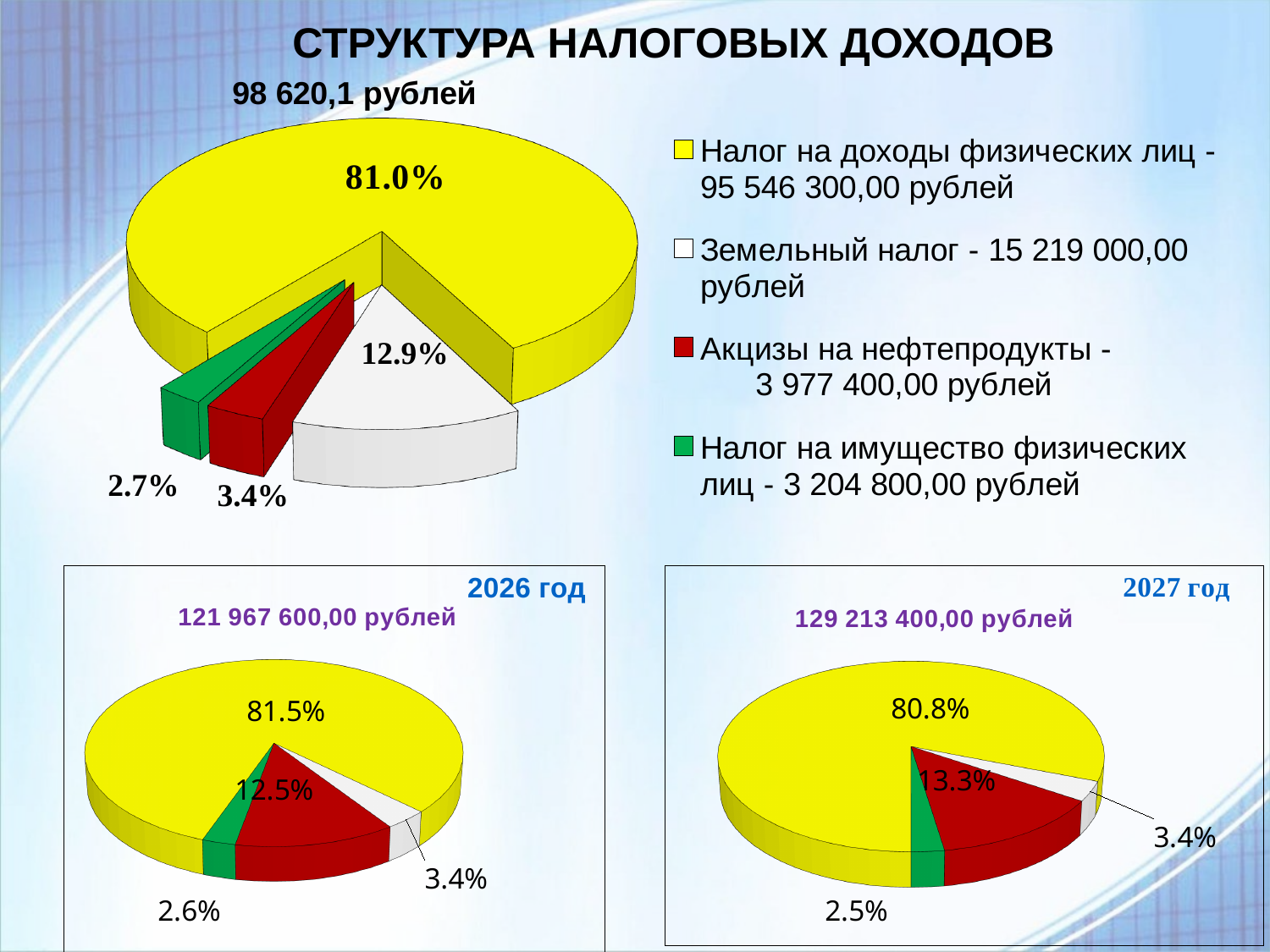
What kind of chart is used on this slide? Pie chart In the 2026 год chart, what is the largest percentage shown? 81.5% In the 2027 год chart, what is the smallest percentage shown? 2.5% In the top pie chart, what percentage is shown for the white slice (Земельный налог)? 12.9% In the top pie chart, what percentage is shown for the red slice (Акцизы на нефтепродукты)? 3.4% According to the legend of the top chart, what is the amount for Налог на доходы физических лиц? 95 546 300,00 рублей What total amount is shown above the 2027 год chart? 129 213 400,00 рублей According to the legend of the top chart, what is the amount for Земельный налог? 15 219 000,00 рублей In the top pie chart, what percentage is shown for the green slice (Налог на имущество физических лиц)? 2.7% How many categories does the legend of the top chart list? 4 Which is larger: the largest slice in the 2026 год chart or the largest slice in the 2027 год chart? 2026 год (81.5%)